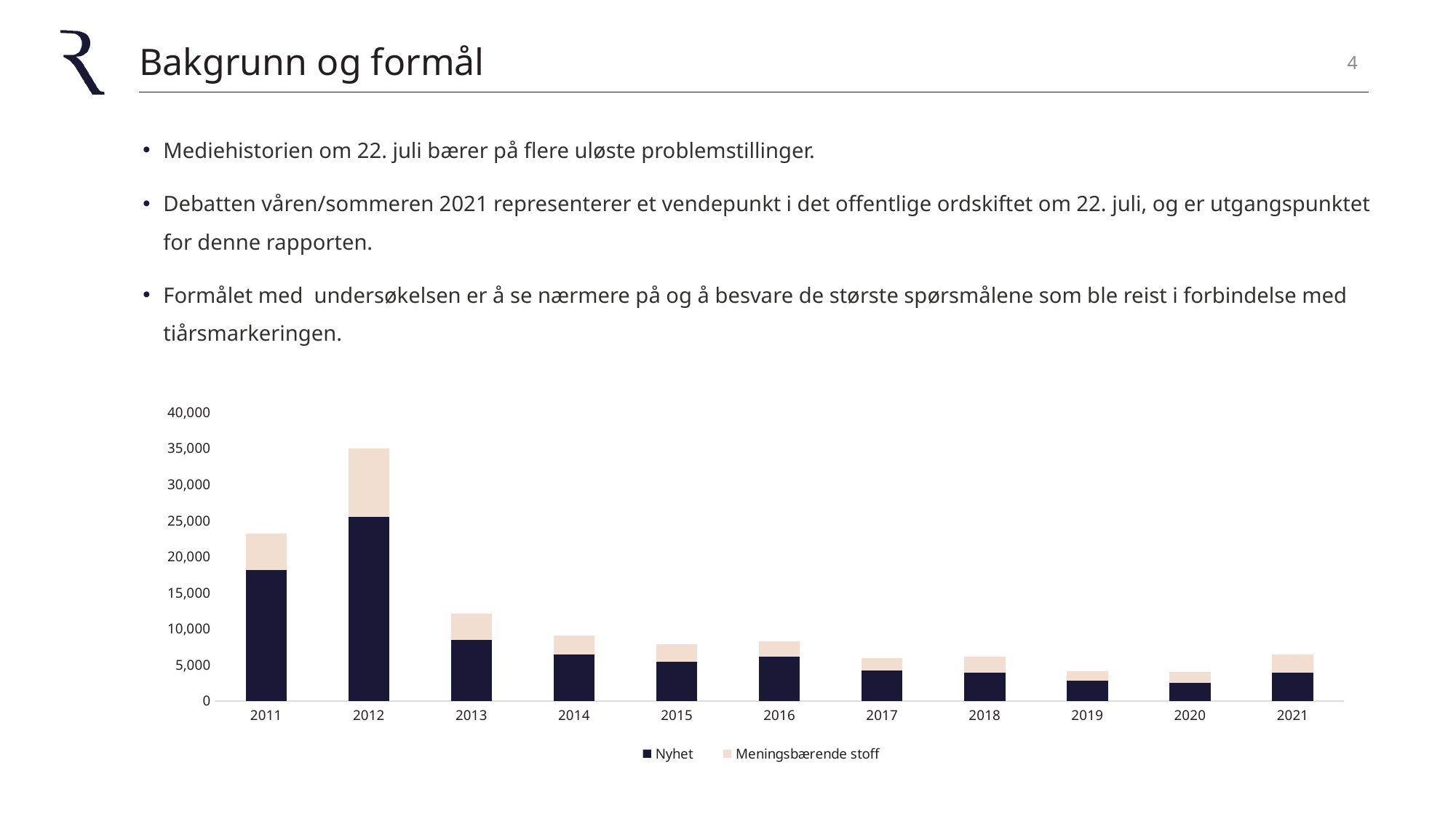
Is the total value for 2013 greater or less than 10,000? greater Which year has the lowest total bar in the chart? 2020 Do the total bar values generally rise or fall from 2012 to 2020? fall Which series are listed in the chart's legend? Nyhet and Meningsbærende stoff Is the Nyhet value for 2011 greater or less than 15,000? greater What kind of chart is shown on the slide? Stacked bar chart Is the total value for 2012 greater or less than 30,000? greater Which year has a larger total bar, 2011 or 2013? 2011 How many years are shown on the x axis of the chart? 11 Which year has the highest total bar in the chart? 2012 How many series does the chart's legend list? 2